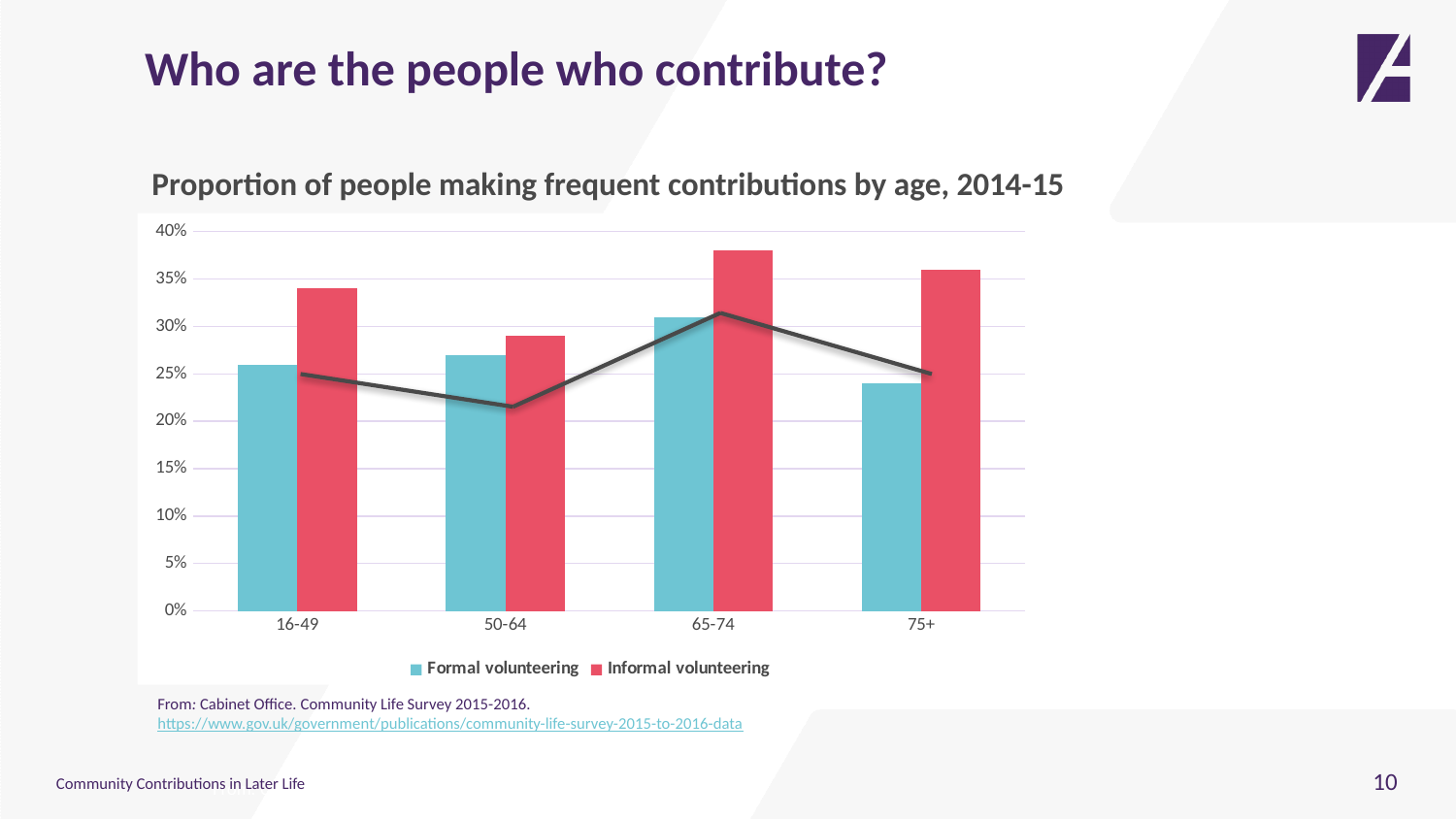
Which age group has the highest value for Formal volunteering? 65-74 How many series does the legend list? 2 How many age groups are shown on the x axis? 4 Does the value for Informal volunteering rise or fall from the 50-64 age group to the 65-74 age group? rise Is the value for Formal volunteering in the 75+ age group greater or less than 25%? less Which age group has the lowest value for Formal volunteering? 75+ Which age group has the lowest value for Informal volunteering? 50-64 Is the value for Informal volunteering in the 65-74 age group greater or less than 35%? greater What kind of chart is shown on the slide? bar chart Which age group has the highest value for Informal volunteering? 65-74 For the 16-49 age group, which is larger: Formal volunteering or Informal volunteering? Informal volunteering What is the title of the chart? Proportion of people making frequent contributions by age, 2014-15